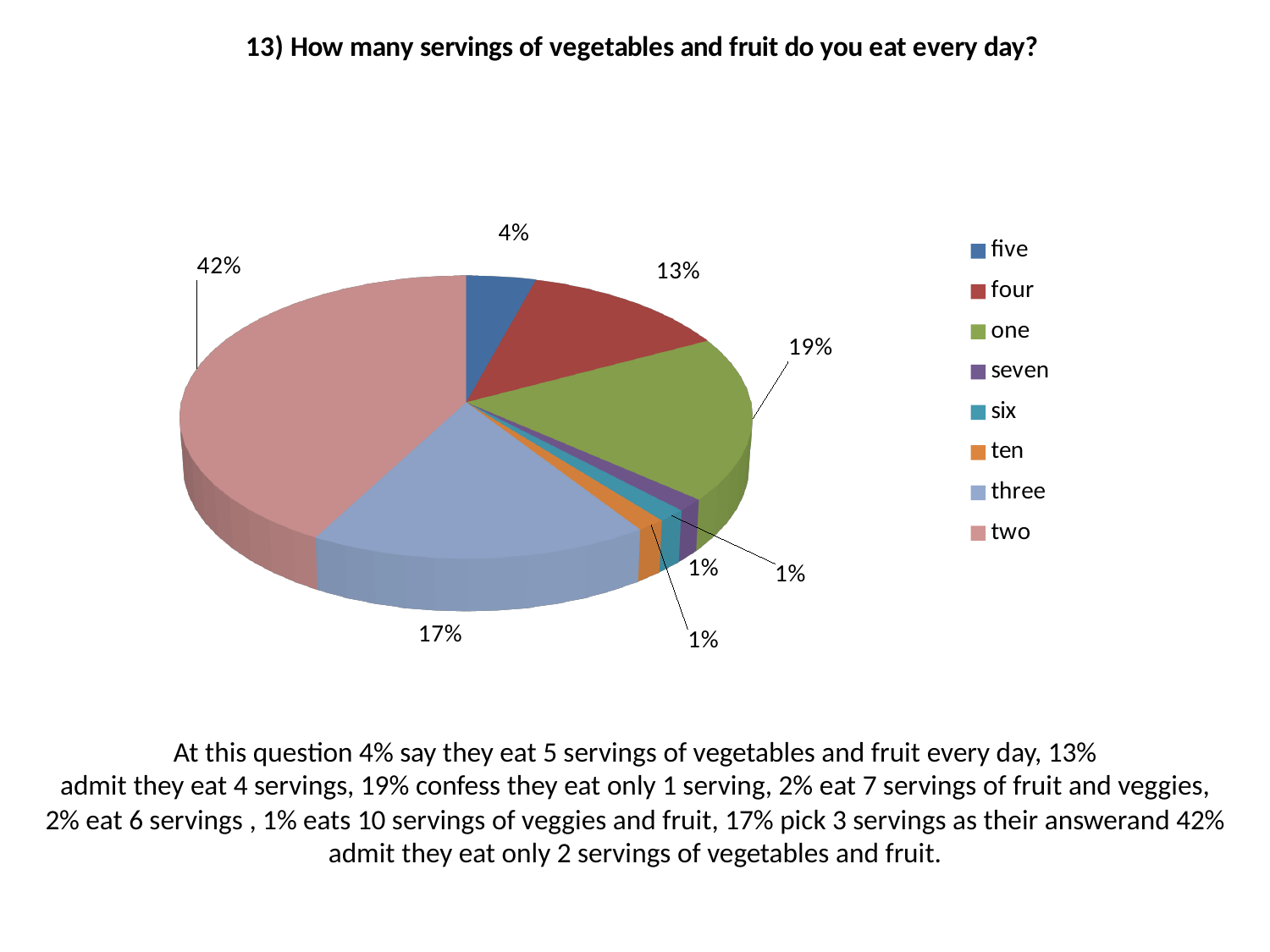
What percentage is shown for the 'four' slice? 13% What kind of chart is shown on the slide? pie chart What percentage is shown for the 'one' slice? 19% Which slice is larger, 'one' or 'four'? one How much larger is the 'two' slice than the 'three' slice, in percentage points? 25% What percentage is shown for the 'three' slice? 17% What is the title of the chart? 13) How many servings of vegetables and fruit do you eat every day? What percentage is shown for the 'five' slice? 4% How many categories does the legend list? 8 What share of the pie does the 'two' slice represent? 42% What percentage of respondents eat two servings of vegetables and fruit every day? 42% Which category has the largest slice of the pie? two